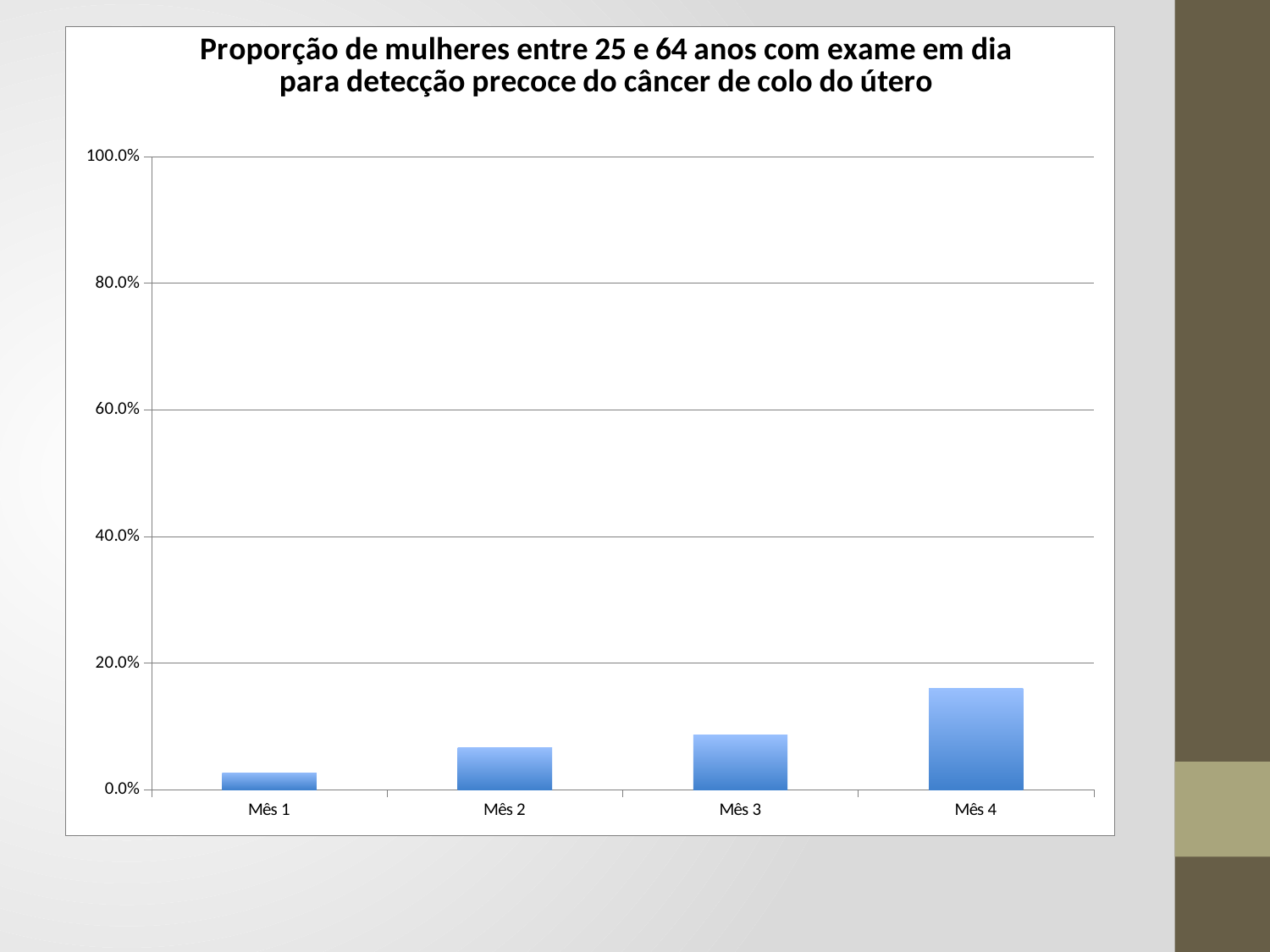
Do the values rise or fall from Mês 1 to Mês 4? rise What kind of chart is shown on the slide? bar chart How many categories (months) are plotted on the x axis? 4 Which month has the lowest proportion? Mês 1 What is the title of the chart? Proporção de mulheres entre 25 e 64 anos com exame em dia para detecção precoce do câncer de colo do útero Which month has the highest proportion? Mês 4 Is the value for Mês 1 greater or less than 20.0%? less Which is larger, the value for Mês 2 or the value for Mês 4? Mês 4 Which is larger, the value for Mês 1 or the value for Mês 4? Mês 4 Is the value for Mês 4 greater or less than 20.0%? less What is the highest value shown on the vertical axis? 100.0% Which is larger, the value for Mês 1 or the value for Mês 3? Mês 3